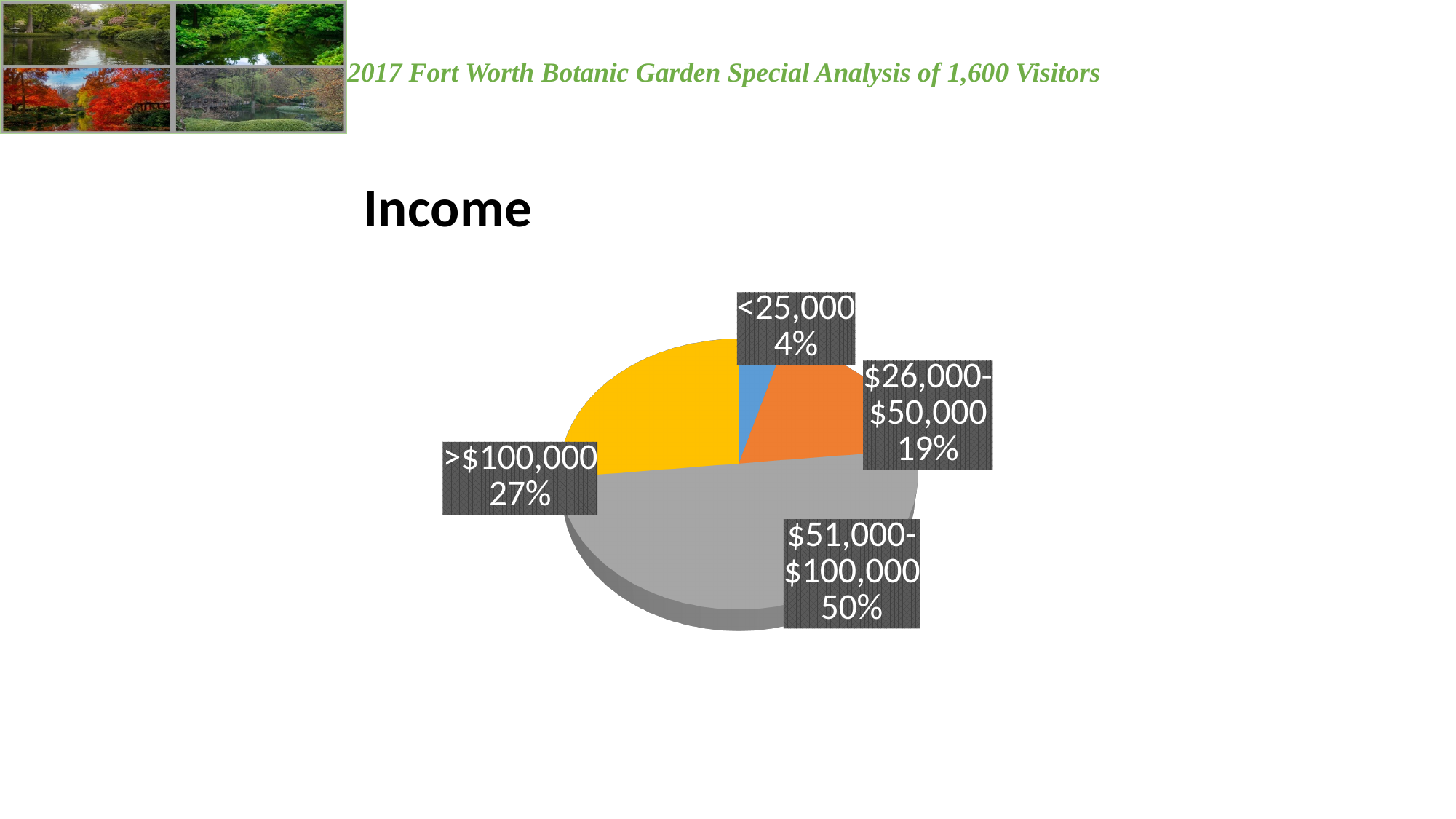
What kind of chart is shown on the slide? Pie chart What share of visitors have an income of >$100,000? 27% Which is larger: the share for $26,000-$50,000 or the share for >$100,000? >$100,000 What colour is the slice for $51,000-$100,000? Gray What is the title of the chart? Income What share of visitors have an income of $51,000-$100,000? 50% Which income category has the largest share of visitors? $51,000-$100,000 What share of visitors have an income of <25,000? 4% How many income categories are shown in the pie chart? 4 What share of visitors have an income of $26,000-$50,000? 19% Which income category has the smallest share of visitors? <25,000 What is the difference in percentage points between the $51,000-$100,000 slice and the >$100,000 slice? 23